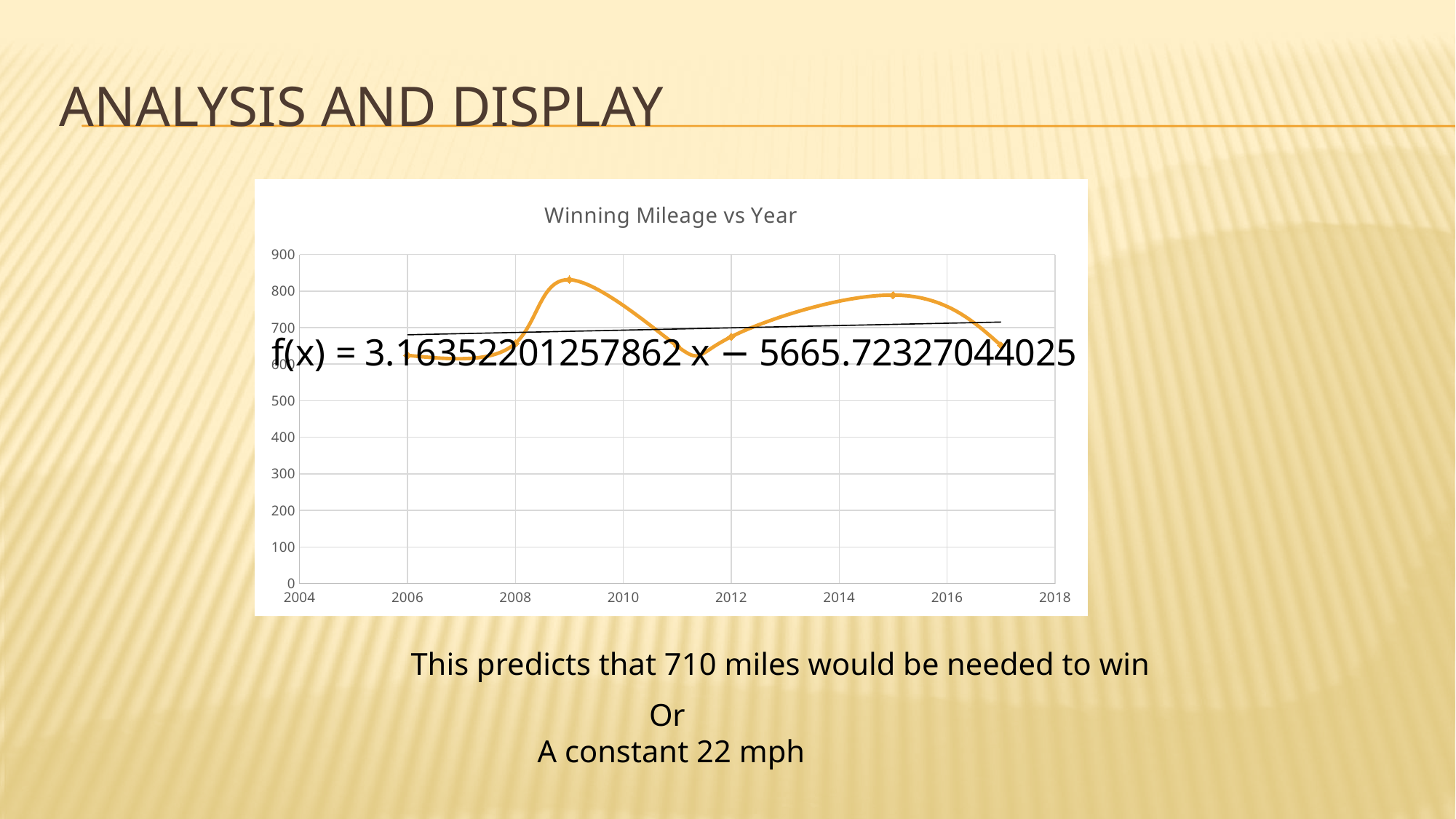
In which year does the winning mileage reach its highest value? 2009 Which year has the higher winning mileage, 2009 or 2015? 2009 Is the winning mileage for 2009 greater or less than 800? greater What is the title of the chart? Winning Mileage vs Year Which year has the higher winning mileage, 2012 or 2015? 2015 Is the winning mileage for 2012 greater or less than 800? less Does the black trendline rise or fall from left to right? rise What kind of chart is shown on the slide? line chart What is the highest value shown on the vertical axis? 900 Is the winning mileage for 2012 greater or less than 600? greater